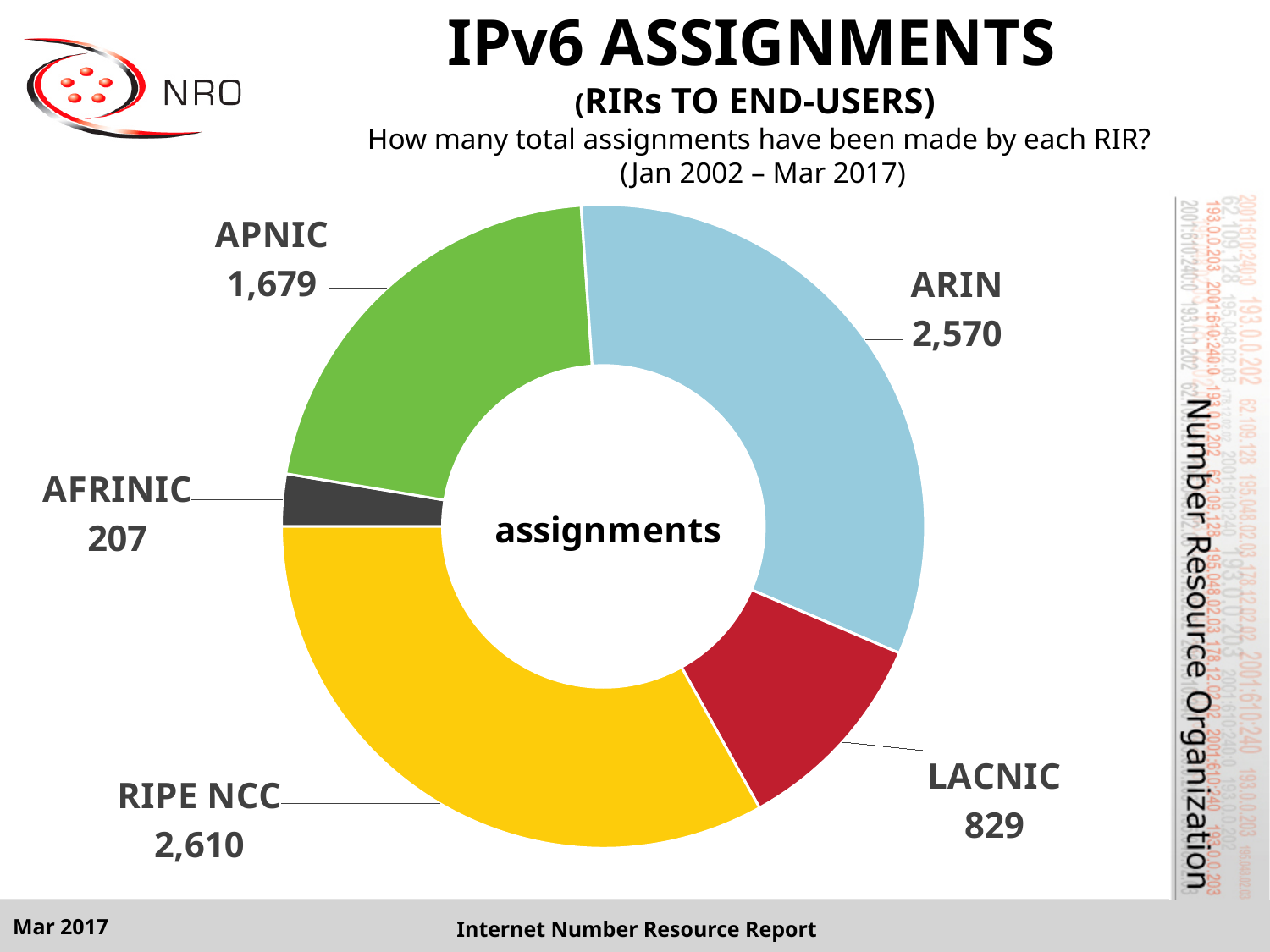
Which RIR has made the most IPv6 assignments? RIPE NCC What is the number of IPv6 assignments made by AFRINIC? 207 What is the number of IPv6 assignments made by APNIC? 1,679 Which RIR has made the fewest IPv6 assignments? AFRINIC How many RIRs are shown in the chart? 5 What kind of chart is used to show the IPv6 assignments? doughnut (pie) chart What is the number of IPv6 assignments made by LACNIC? 829 What is the number of IPv6 assignments made by ARIN? 2,570 Which has made more IPv6 assignments, APNIC or LACNIC? APNIC How many more IPv6 assignments has RIPE NCC made than ARIN? 40 What is the number of IPv6 assignments made by RIPE NCC? 2,610 What is the difference between the IPv6 assignments of APNIC and AFRINIC? 1,472